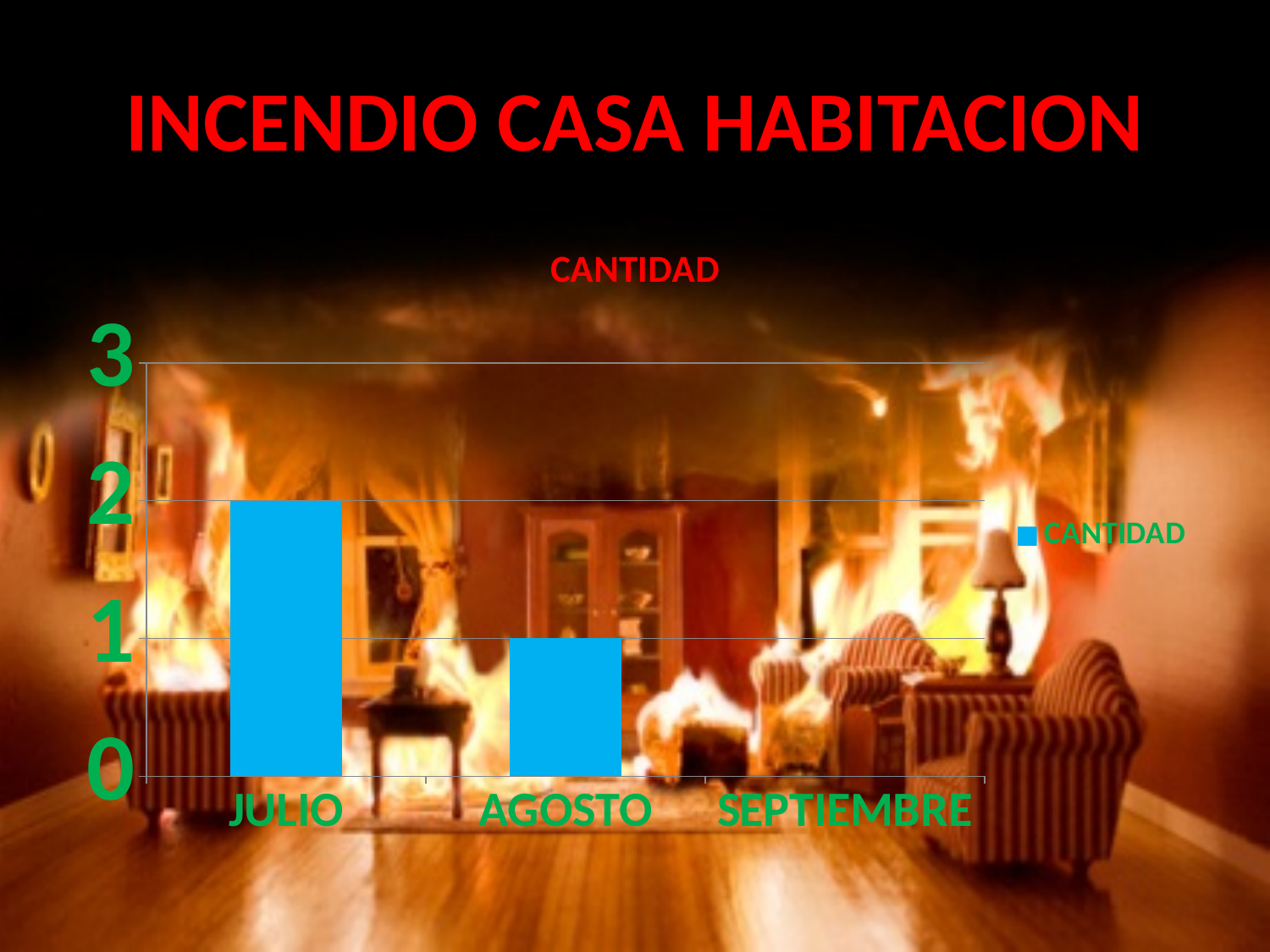
Is the value for JULIO greater or less than 3? less What kind of chart is shown on the slide? bar chart What is the title of the chart? CANTIDAD What is the difference between the values for JULIO and AGOSTO? 1 Do the values rise or fall from JULIO to AGOSTO? fall Which is larger, the value for JULIO or the value for AGOSTO? JULIO What is the value for AGOSTO in the CANTIDAD chart? 1 How many series does the legend list? 1 How many categories are shown on the x axis of the chart? 3 What colour are the bars in the chart? blue What is the value for JULIO in the CANTIDAD chart? 2 Which month has the highest value in the chart? JULIO